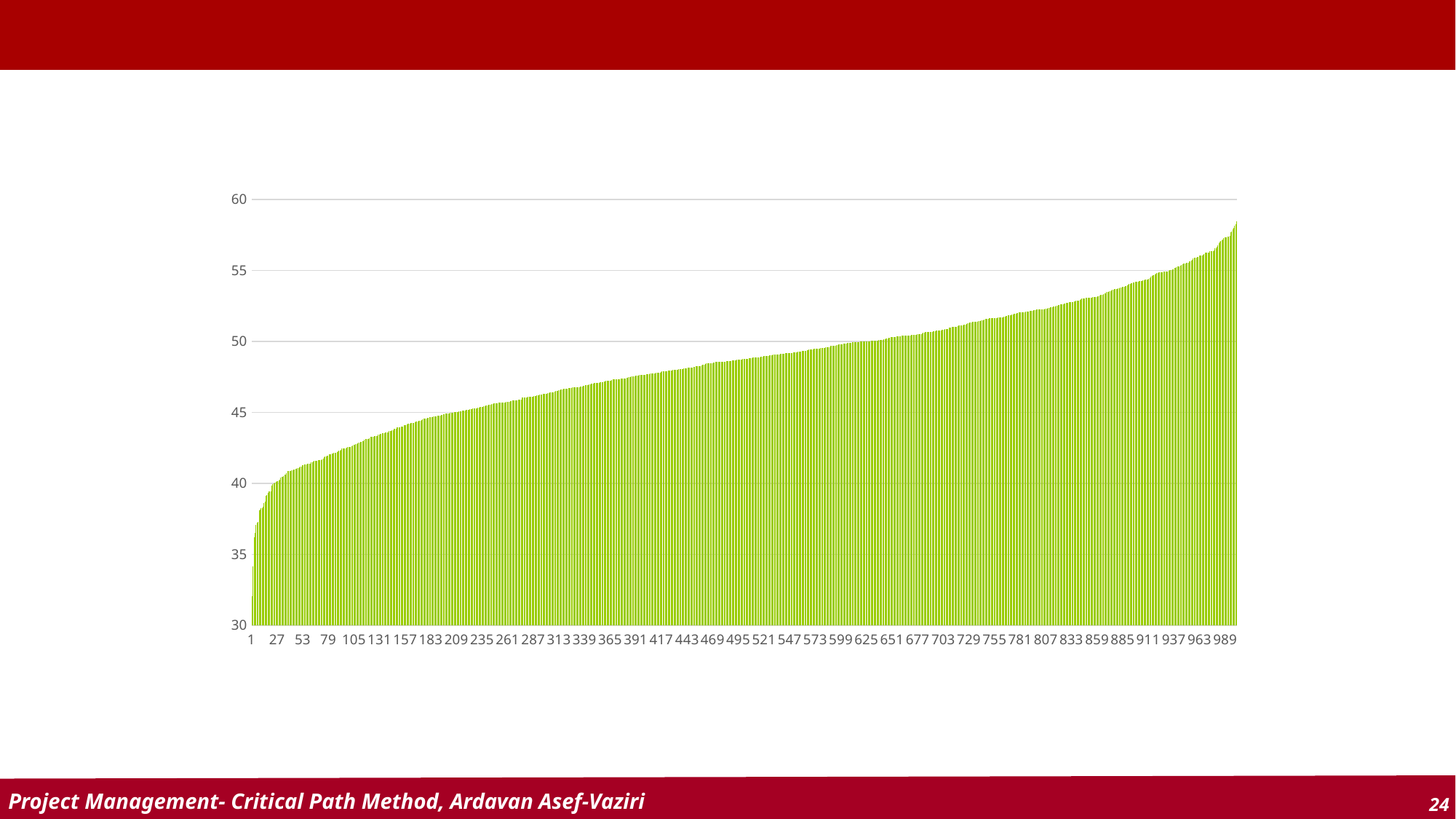
Is the value for category 807 greater or less than 50? greater Is the value for category 261 greater or less than 50? less What is the lowest value shown on the vertical axis? 30 What kind of chart is shown on the slide? bar chart Which is larger, the value for category 443 or the value for category 79? 443 What colour are the bars in the chart? green Which is larger, the value for category 27 or the value for category 963? 963 Is the value for category 1 greater or less than 40? less Do the values rise or fall as you move from left to right along the x axis? rise